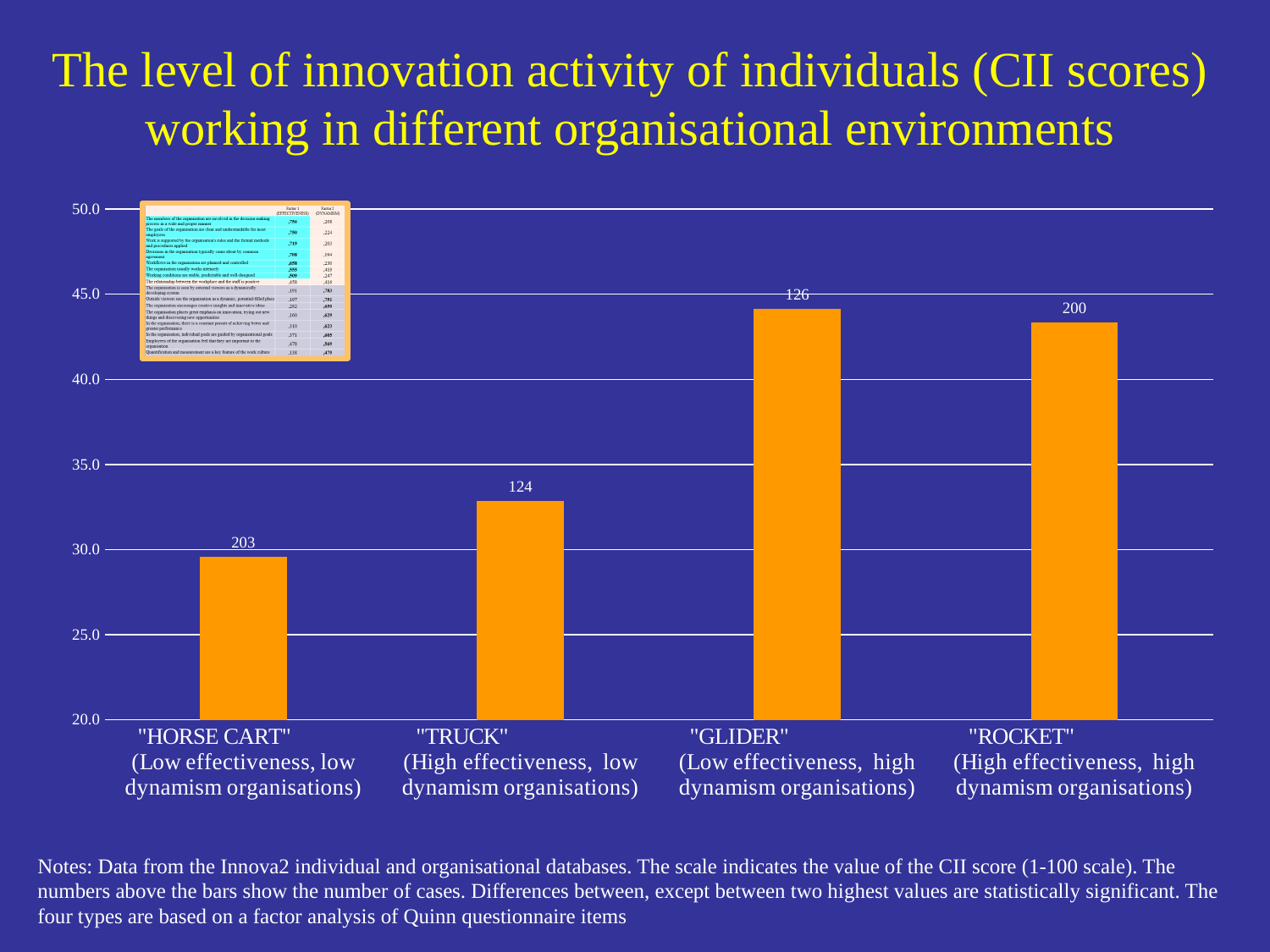
Is the CII score for "HORSE CART" greater or less than 30.0? less Which organisational environment has the highest CII score bar? "GLIDER" What number of cases is printed above the "GLIDER" bar? 126 Which has the larger CII score, "TRUCK" or "HORSE CART"? "TRUCK" What is the lowest value shown on the y axis of the chart? 20.0 What number of cases is printed above the "HORSE CART" bar? 203 Is the CII score for "GLIDER" greater or less than 45.0? less Is the CII score for "ROCKET" greater or less than 40.0? greater Which organisational environment has the lowest CII score bar? "HORSE CART" How many organisational environment types (categories) are shown on the x axis? 4 What kind of chart is shown on the slide? bar chart